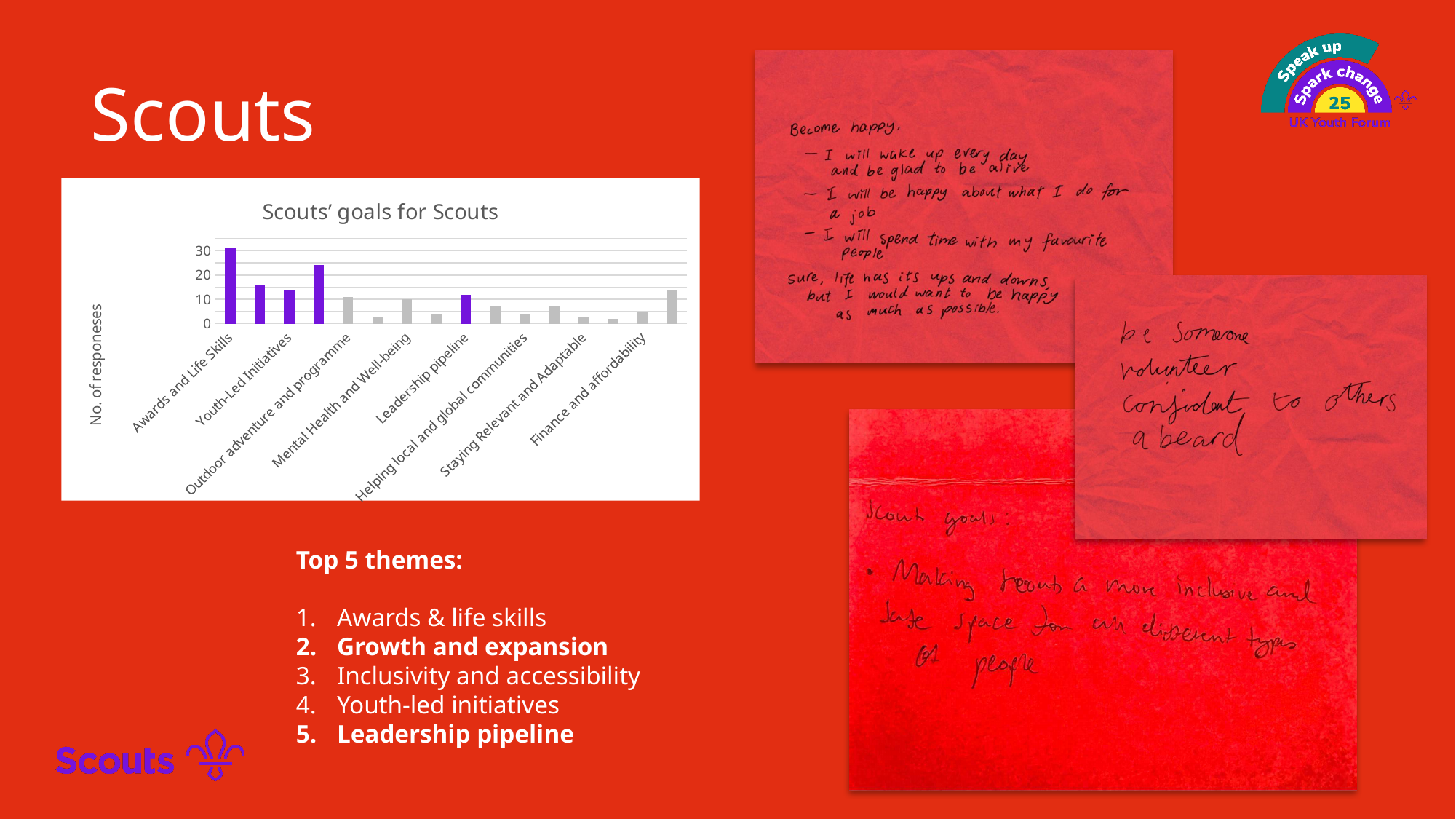
Is the value for Youth-Led Initiatives greater or less than 10? greater Which category has the highest number of responses? Awards and Life Skills What is the label on the vertical axis of the chart? No. of responses What kind of chart is shown on the slide? Bar chart Which has more responses, Youth-Led Initiatives or Finance and affordability? Youth-Led Initiatives Is the value for Awards and Life Skills greater or less than 20? greater Which has more responses, Awards and Life Skills or Youth-Led Initiatives? Awards and Life Skills What is the title of the chart? Scouts' goals for Scouts Is the value for Finance and affordability greater or less than 10? less Which has more responses, Leadership pipeline or Staying Relevant and Adaptable? Leadership pipeline